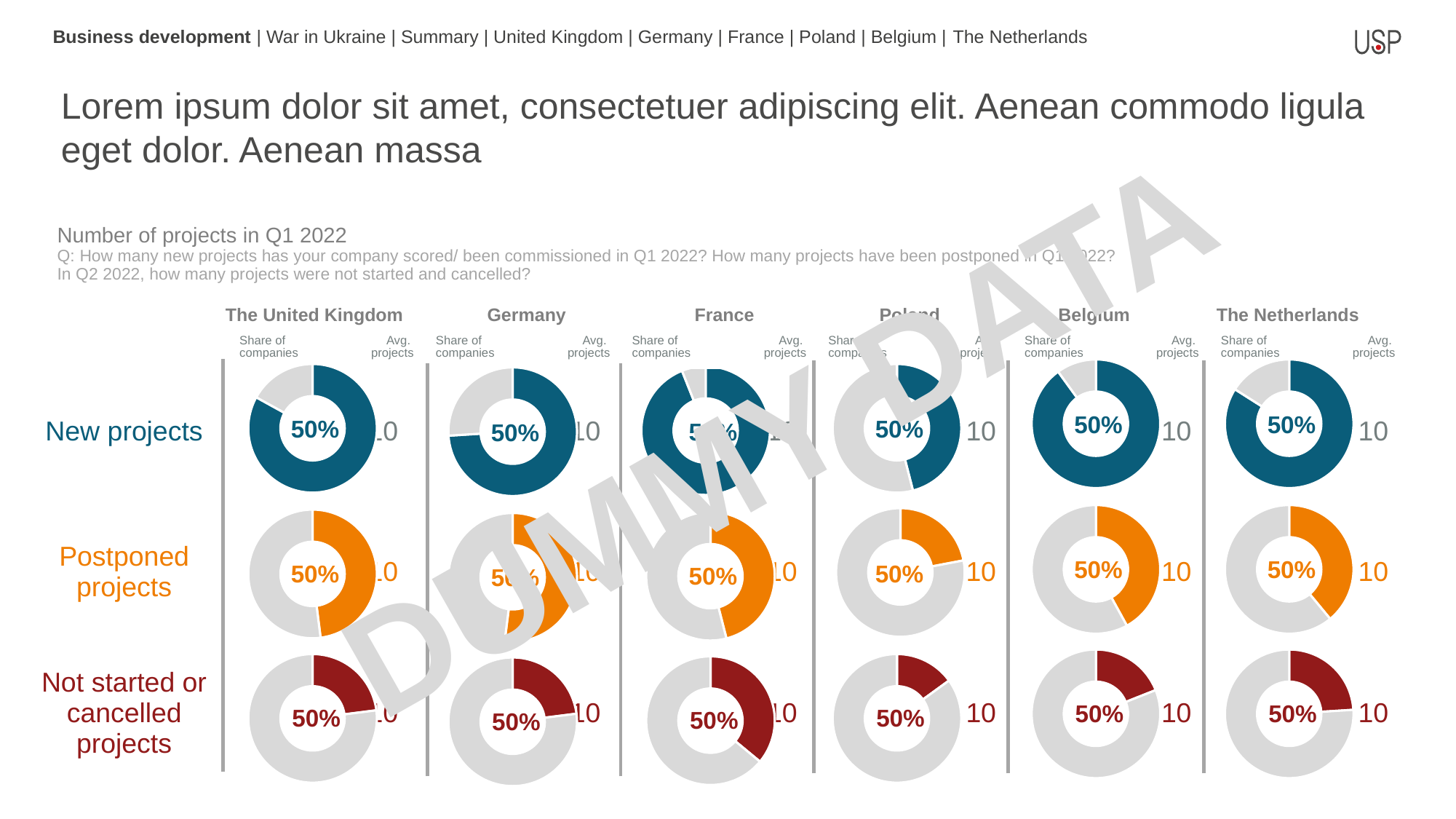
What colour is used for the postponed projects donut charts? orange What is the share of companies for postponed projects in The United Kingdom? 50% What is the average number of postponed projects in The Netherlands? 10 How many countries are shown with donut charts on the slide? 6 What is the share of companies for new projects in Belgium? 50% What is the average number of new projects in Belgium? 10 What is the share of companies for new projects in Poland? 50% How many project categories (rows of donut charts) are shown on the slide? 3 What kind of chart is used to show the share of companies for each country and project category? donut chart What is the share of companies for not started or cancelled projects in Germany? 50% What is the title of the chart section on the slide? Number of projects in Q1 2022 What is the average number of not started or cancelled projects in Poland? 10